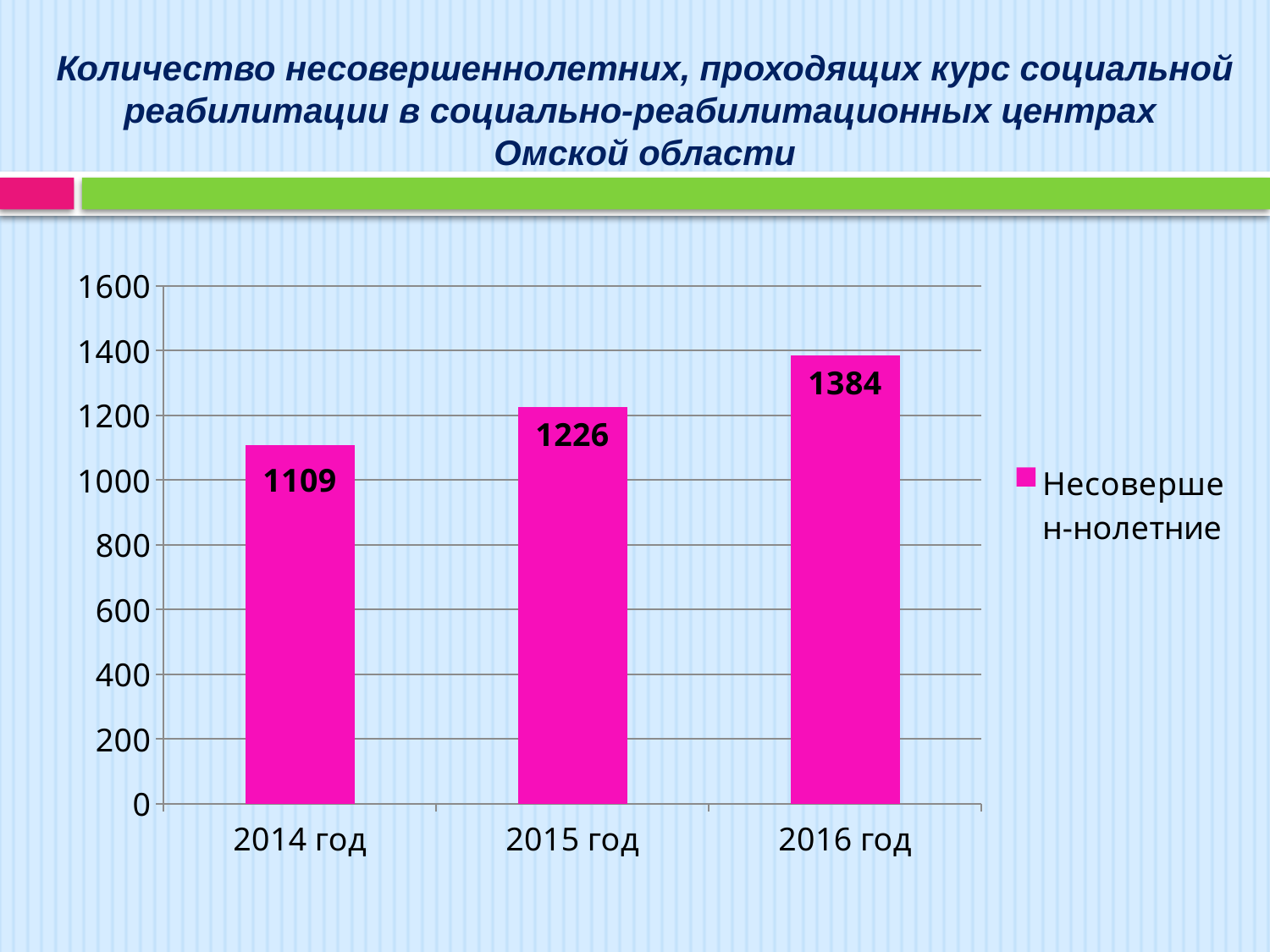
Do the values rise or fall from 2014 год to 2016 год? rise Which year has the highest value? 2016 год What is the difference between the values for 2015 год and 2014 год? 117 How many years are shown on the x axis? 3 Which is larger, the value for 2015 год or the value for 2016 год? 2016 год Is the value for 2014 год greater or less than 1200? less What is the value for 2015 год? 1226 What is the value for 2014 год? 1109 What is the value for 2016 год? 1384 What is the difference between the values for 2016 год and 2014 год? 275 What kind of chart is shown on the slide? bar chart Which year has the lowest value? 2014 год